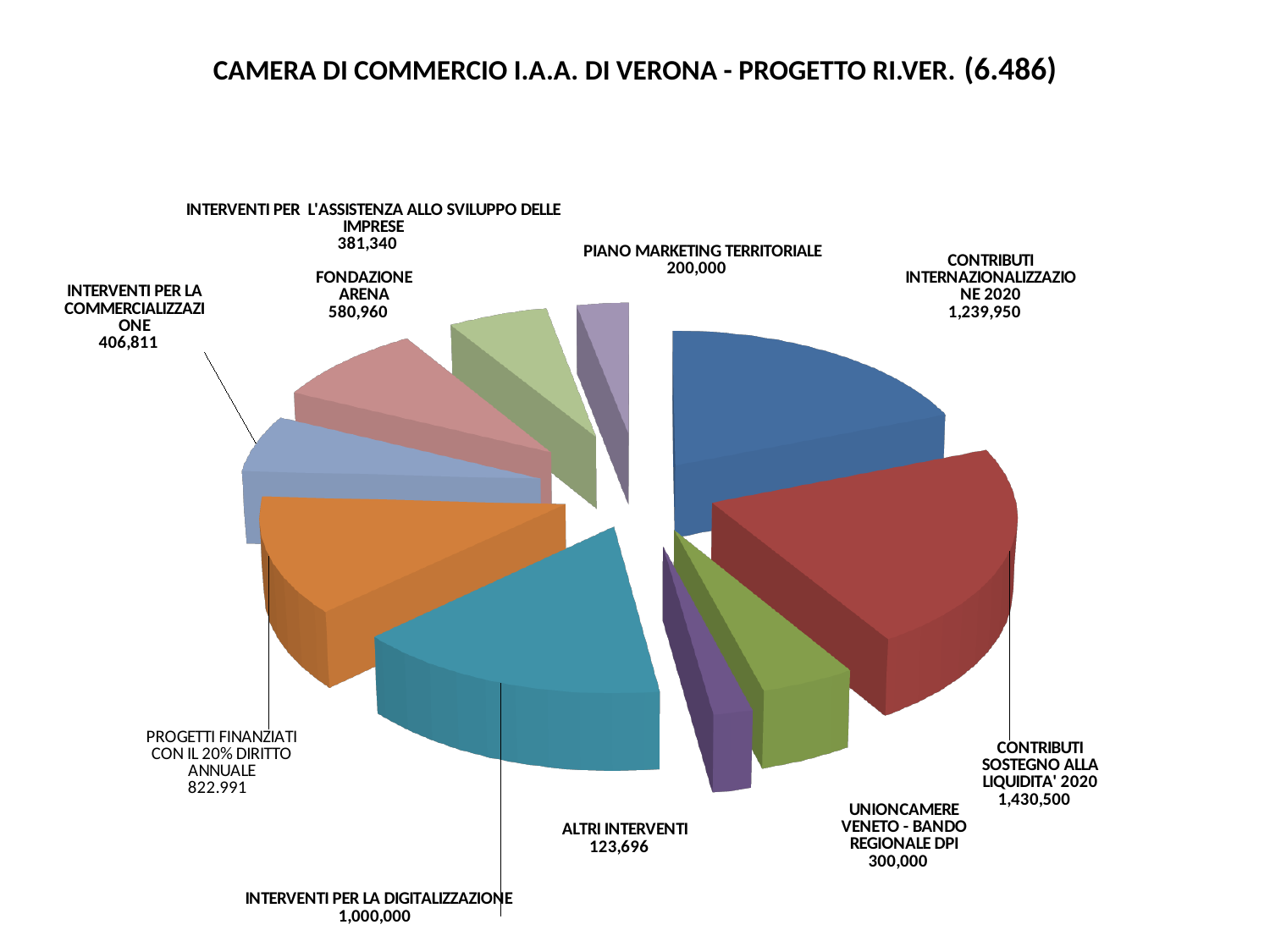
Which is larger, FONDAZIONE ARENA or INTERVENTI PER LA COMMERCIALIZZAZIONE? FONDAZIONE ARENA What is the value for UNIONCAMERE VENETO - BANDO REGIONALE DPI? 300,000 Which category has the largest slice of the pie? CONTRIBUTI SOSTEGNO ALLA LIQUIDITA' 2020 What is the value for CONTRIBUTI SOSTEGNO ALLA LIQUIDITA' 2020? 1,430,500 What is the title of the chart? CAMERA DI COMMERCIO I.A.A. DI VERONA - PROGETTO RI.VER. (6.486) Which category has the smallest slice of the pie? ALTRI INTERVENTI What is the value for FONDAZIONE ARENA? 580,960 What is the difference between INTERVENTI PER LA DIGITALIZZAZIONE and UNIONCAMERE VENETO - BANDO REGIONALE DPI? 700,000 What is the value for INTERVENTI PER LA DIGITALIZZAZIONE? 1,000,000 How many slices does the pie chart have? 10 What type of chart is shown on the slide? Pie chart What is the difference between CONTRIBUTI SOSTEGNO ALLA LIQUIDITA' 2020 and CONTRIBUTI INTERNAZIONALIZZAZIONE 2020? 190,550